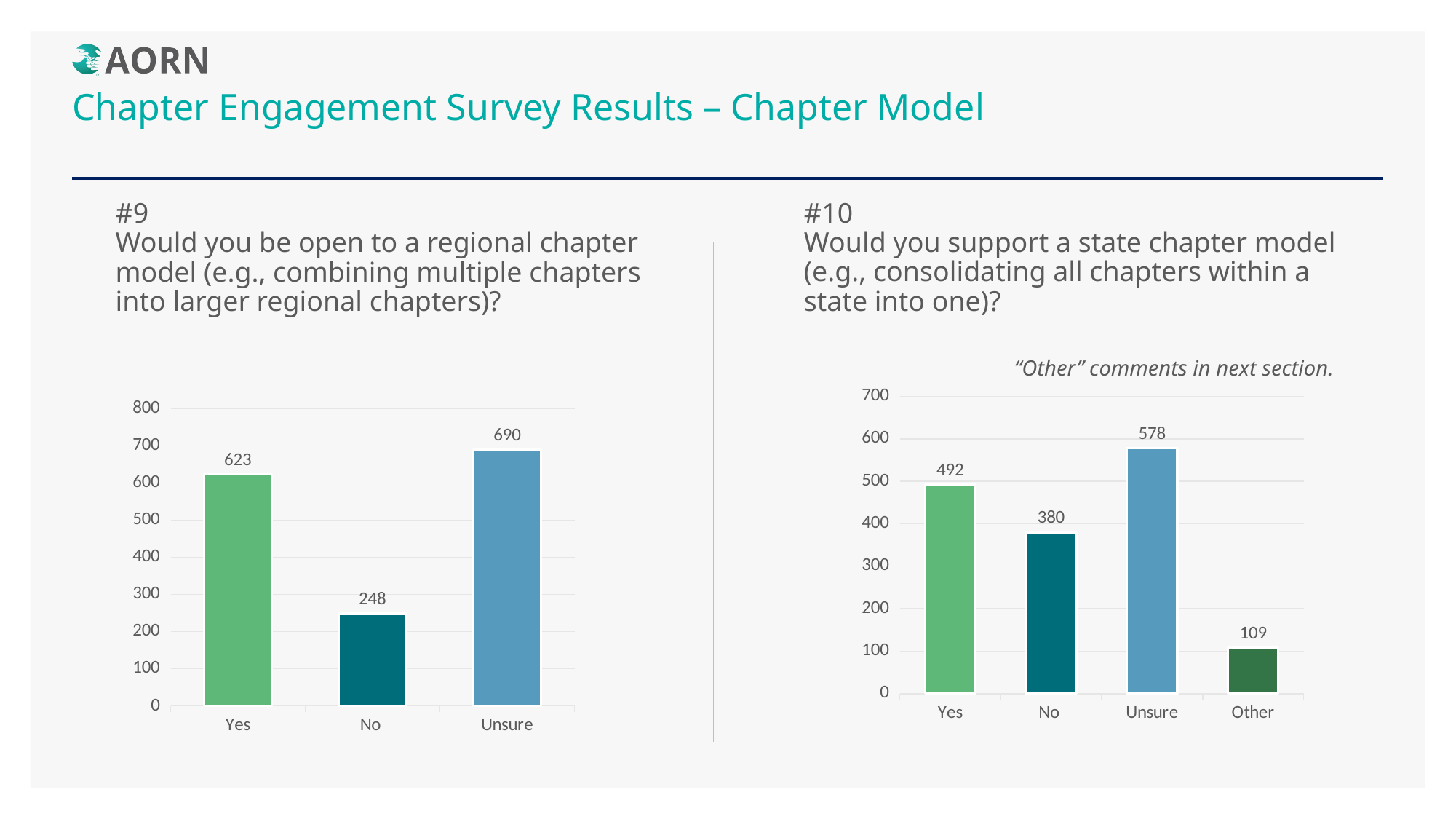
In the left chart (#9, regional chapter model), how many categories are shown? 3 In the left chart (#9, regional chapter model), what is the difference between Unsure and Yes? 67 In the left chart (#9, regional chapter model), what is the value for Yes? 623 In the right chart (#10, state chapter model), which category has the lowest value? Other What kind of chart is used for the #9 regional chapter model results? Bar chart In the right chart (#10, state chapter model), how many categories are shown? 4 In the right chart (#10, state chapter model), which is larger, Yes or No? Yes In the right chart (#10, state chapter model), what is the value for Other? 109 In the right chart (#10, state chapter model), what is the difference between Yes and No? 112 In the right chart (#10, state chapter model), what is the value for Unsure? 578 In the left chart (#9, regional chapter model), what is the value for No? 248 In the left chart (#9, regional chapter model), which category has the highest value? Unsure